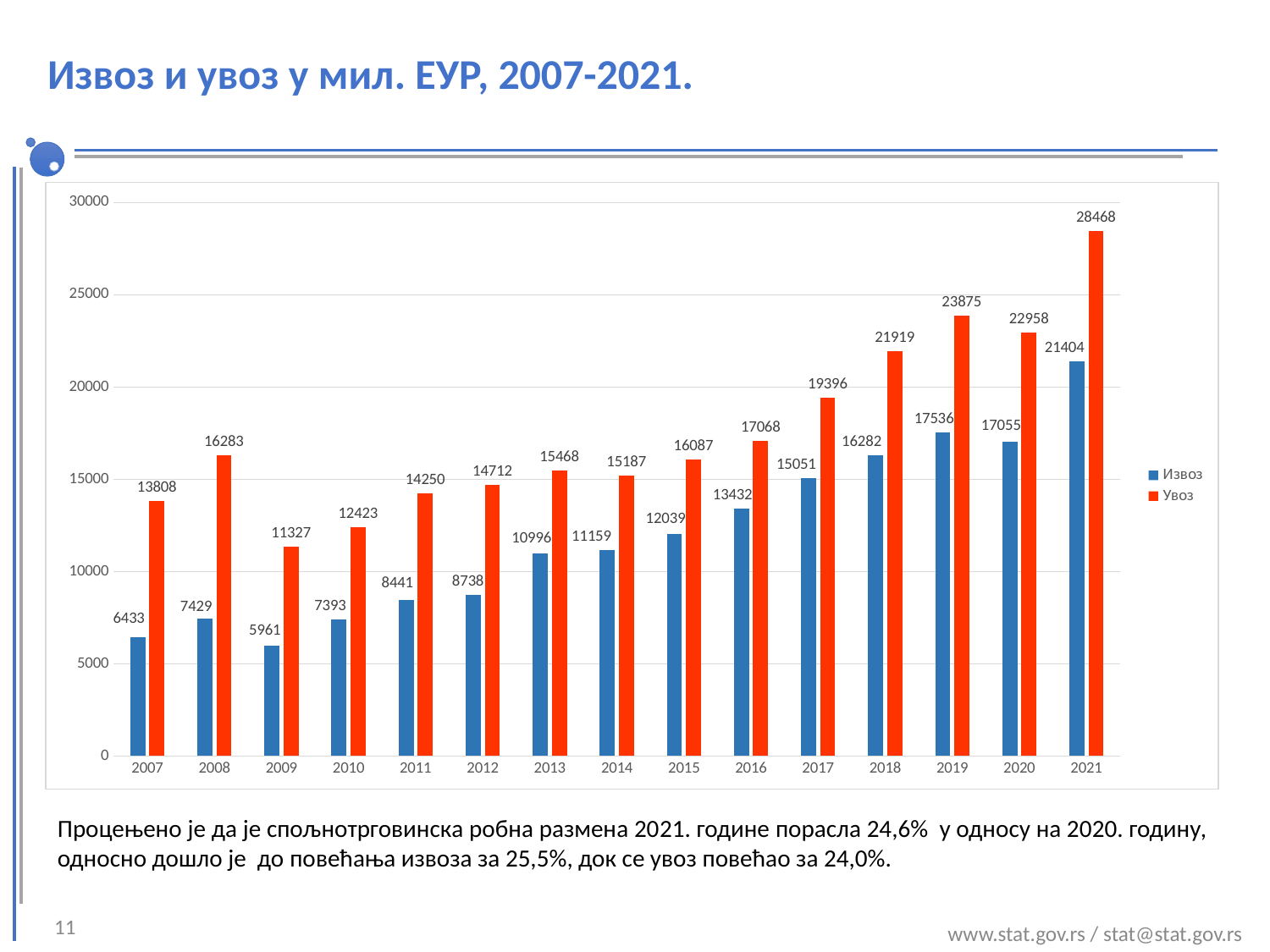
How many series does the legend list? 2 In which year is Увоз (imports) highest? 2021 How many years are shown on the x axis? 15 What is the value of Извоз for 2015? 12039 What kind of chart is shown on the slide? bar chart In which year is Извоз (exports) lowest? 2009 What is the difference between Увоз and Извоз in 2021? 7064 What is the value of Увоз (imports) for 2007? 13808 What is the value of Извоз (exports) for 2021? 21404 Is the value of Извоз for 2019 greater or less than 15000? greater What is the difference between Увоз and Извоз in 2007? 7375 Which is larger in 2020: Извоз or Увоз? Увоз